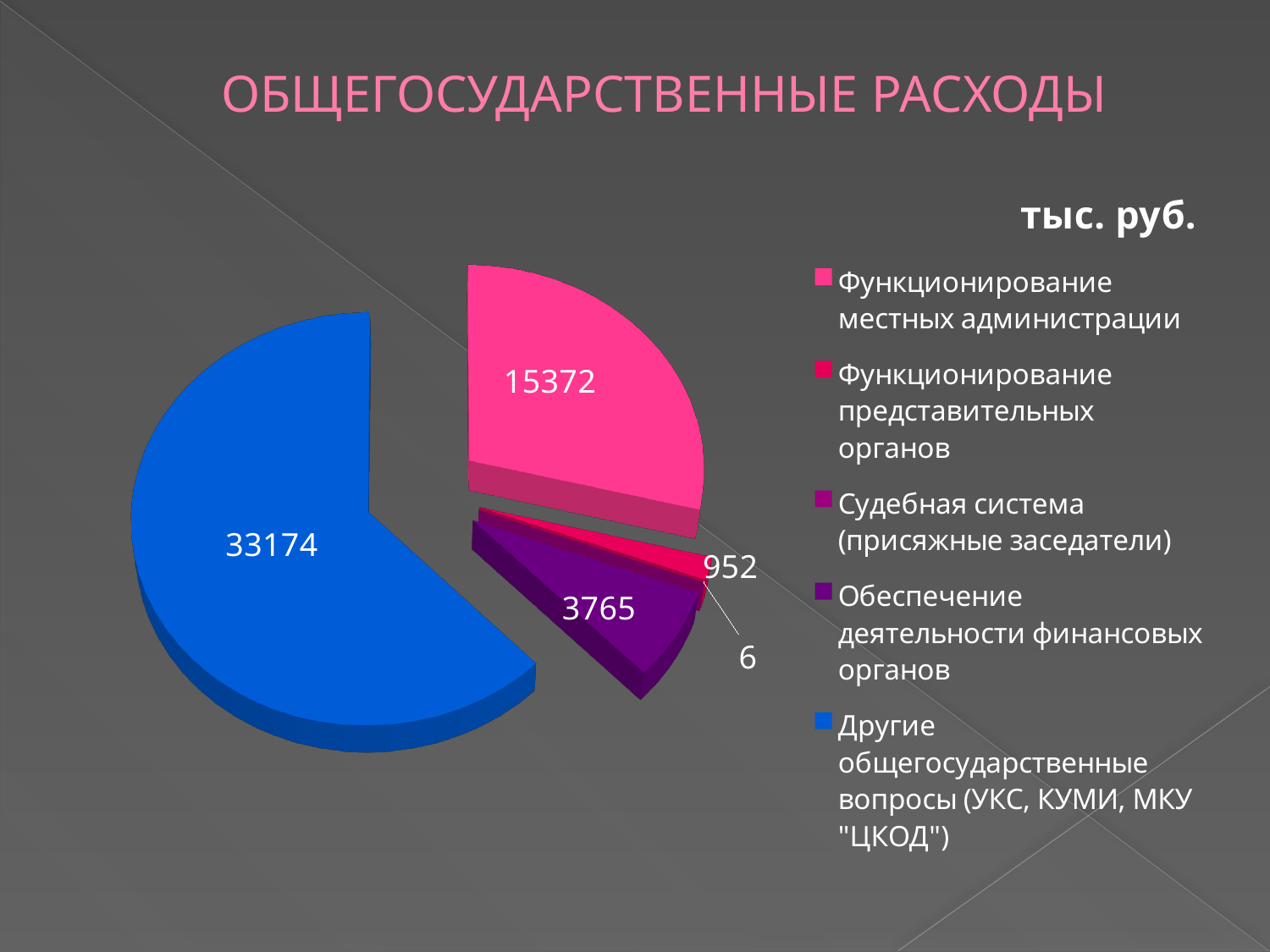
What kind of chart is shown on the slide? pie chart What is the total of all the slices in the pie? 53269 What is the value for Функционирование местных администрации? 15372 What is the value for Функционирование представительных органов? 952 What is the value for Обеспечение деятельности финансовых органов? 3765 What is the value for Судебная система (присяжные заседатели)? 6 Which category has the largest slice of the pie? Другие общегосударственные вопросы (УКС, КУМИ, МКУ "ЦКОД") What is the difference between the values for Другие общегосударственные вопросы and Функционирование местных администрации? 17802 What unit is stated for the values on the slide? тыс. руб. How many categories does the legend list? 5 Which is larger: the value for Обеспечение деятельности финансовых органов or the value for Функционирование представительных органов? Обеспечение деятельности финансовых органов Which category has the smallest slice of the pie? Судебная система (присяжные заседатели)